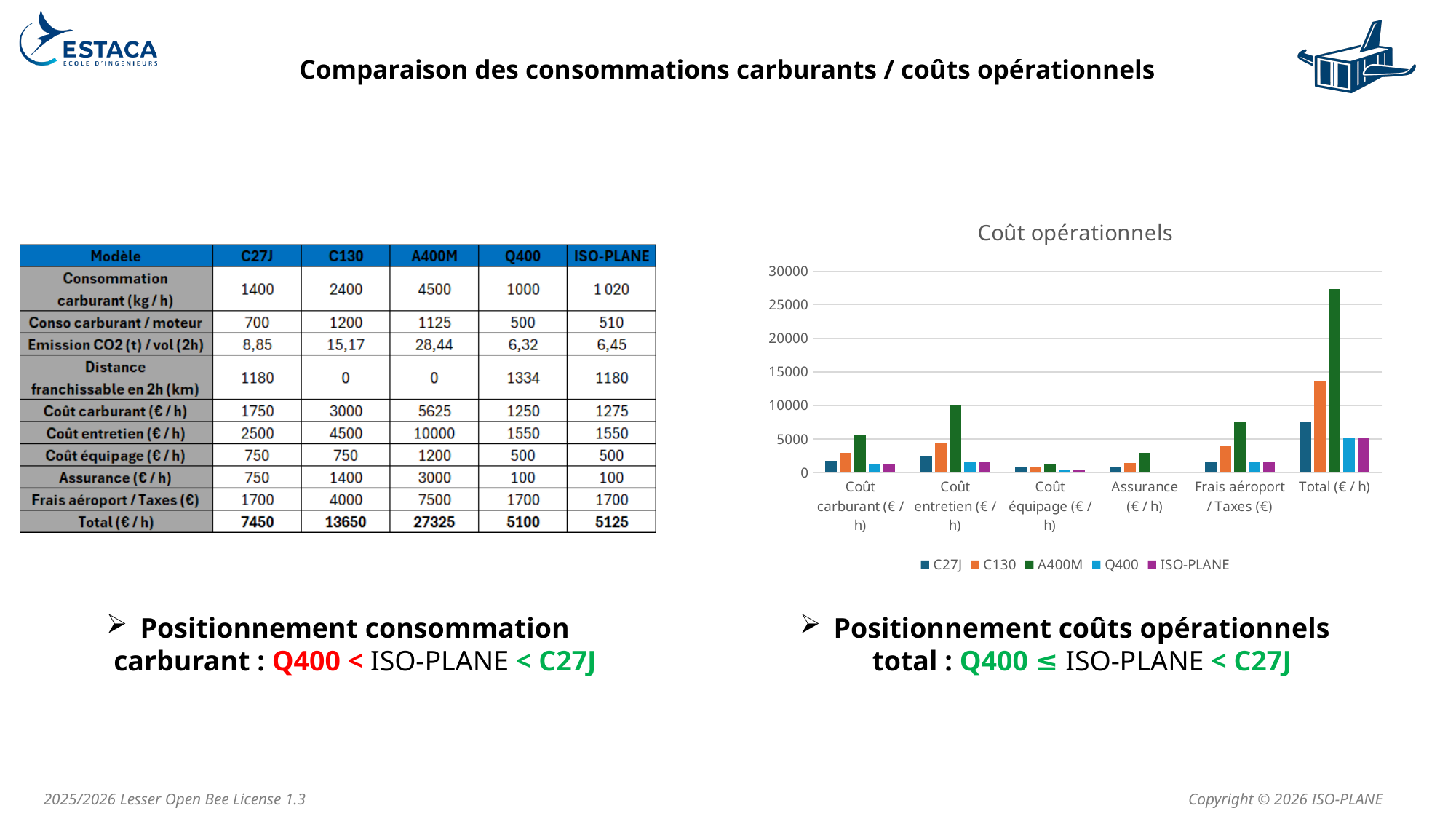
What kind of chart is shown on the slide? bar chart How many series does the legend of the "Coût opérationnels" chart list? 5 According to the table, what is the "Coût entretien (€ / h)" value for A400M plotted in the "Coût opérationnels" chart? 10000 According to the table, what is the "Total (€ / h)" value for A400M plotted in the "Coût opérationnels" chart? 27325 In the "Coût opérationnels" chart, which is larger for "Frais aéroport / Taxes (€)": C130 or C27J? C130 In the "Coût opérationnels" chart, is the "Total (€ / h)" value for A400M greater or less than 25000? greater In the "Coût opérationnels" chart, which model has the highest bar in the "Total (€ / h)" category? A400M How many categories are shown along the x axis of the "Coût opérationnels" chart? 6 In the "Coût opérationnels" chart, which model has the highest bar for "Coût entretien (€ / h)"? A400M Using the values in the table, what is the difference between the "Total (€ / h)" of C130 and C27J? 6200 In the "Coût opérationnels" chart, is the "Total (€ / h)" value for C130 greater or less than 15000? less What is the title of the chart on the slide? Coût opérationnels